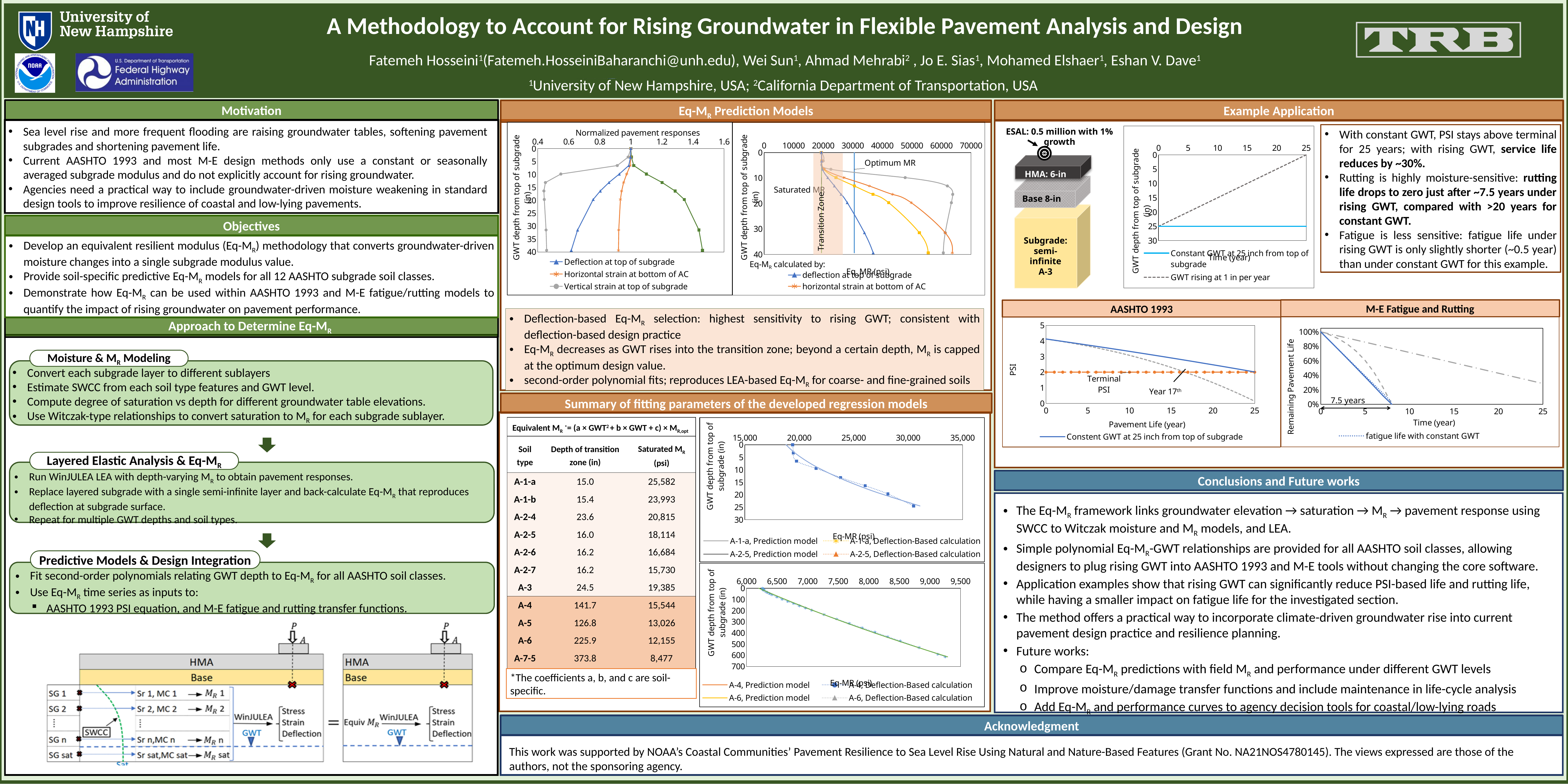
How many series does the legend of the lower chart in the 'Summary of fitting parameters' section (A-4 and A-6) list? 4 In the M-E Fatigue and Rutting chart, after how many years does the annotated rutting life reach zero under rising GWT? 7.5 years In the M-E Fatigue and Rutting chart, does remaining pavement life rise or fall over time? fall In the 'Normalized pavement responses' chart, which series is plotted with the blue triangle markers? Deflection at top of subgrade In the AASHTO 1993 chart, which year is annotated where the rising-GWT curve reaches the terminal PSI? Year 17th How many series does the legend of the upper chart in the 'Summary of fitting parameters' section (A-1-a and A-2-5) list? 4 In the AASHTO 1993 chart, what PSI value is marked as the Terminal PSI? 2 In the Example Application GWT depth chart, at what depth from the top of subgrade is the constant GWT held, according to the legend? 25 inch How many series does the legend of the 'Normalized pavement responses' chart list? 3 In the AASHTO 1993 chart, does PSI rise or fall as pavement life increases? fall What kind of chart is the 'Normalized pavement responses' chart in the Eq-MR Prediction Models section? line chart